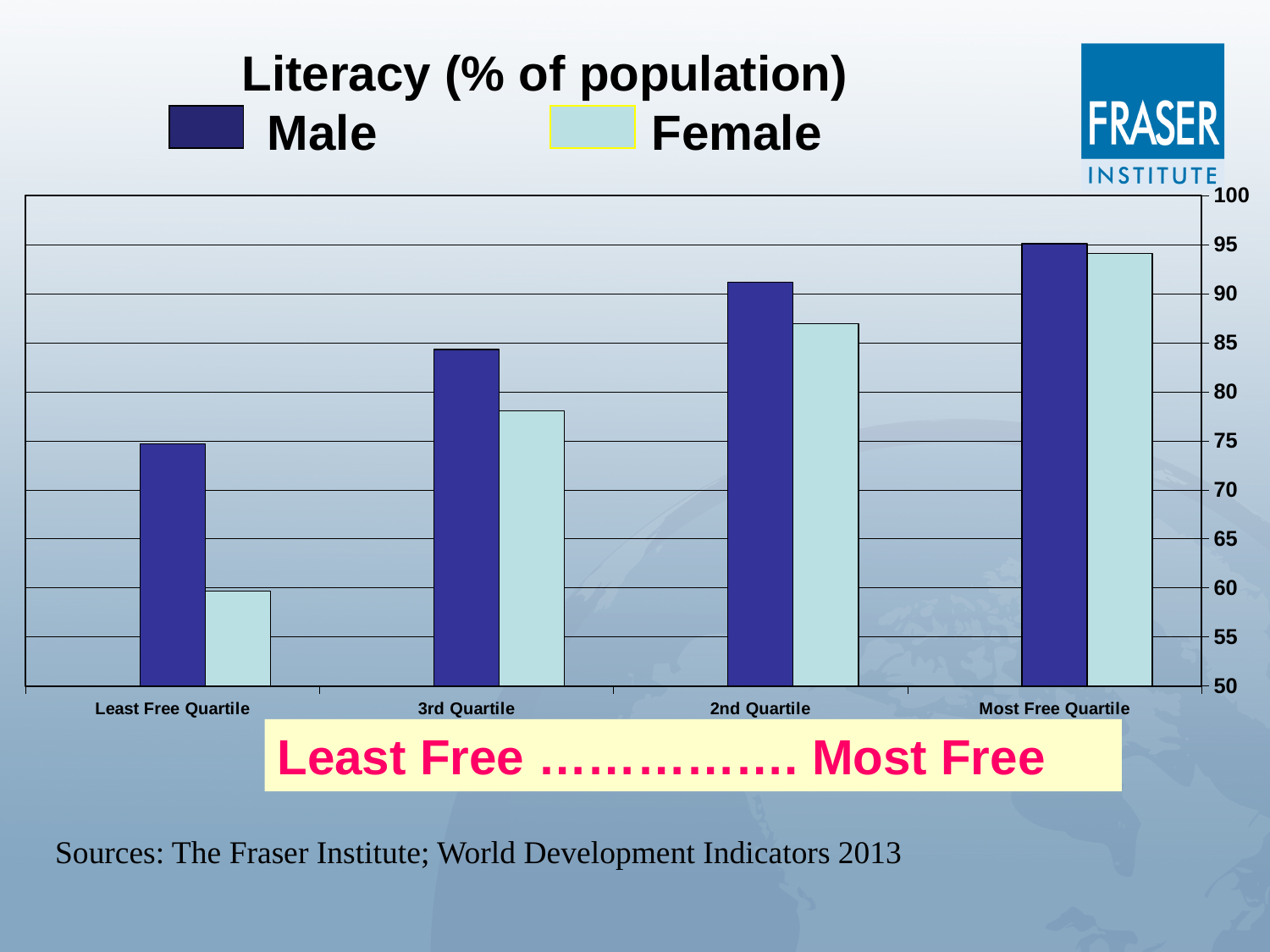
How many categories are shown on the x axis? 4 How many series does the legend list? 2 Which category has the highest Male literacy rate? Most Free Quartile Is the Female literacy value for the Least Free Quartile greater or less than 65? less Is the Male literacy value for the 2nd Quartile greater or less than 90? greater Which series is shown in dark blue? Male Is the Female literacy value for the 3rd Quartile greater or less than 80? less What is the title of the chart? Literacy (% of population) Which category has the lowest Female literacy rate? Least Free Quartile Which is larger in the 3rd Quartile, the Male or the Female literacy rate? Male What kind of chart is shown on the slide? bar chart Do the Female literacy values rise or fall moving from the Least Free Quartile to the Most Free Quartile? rise